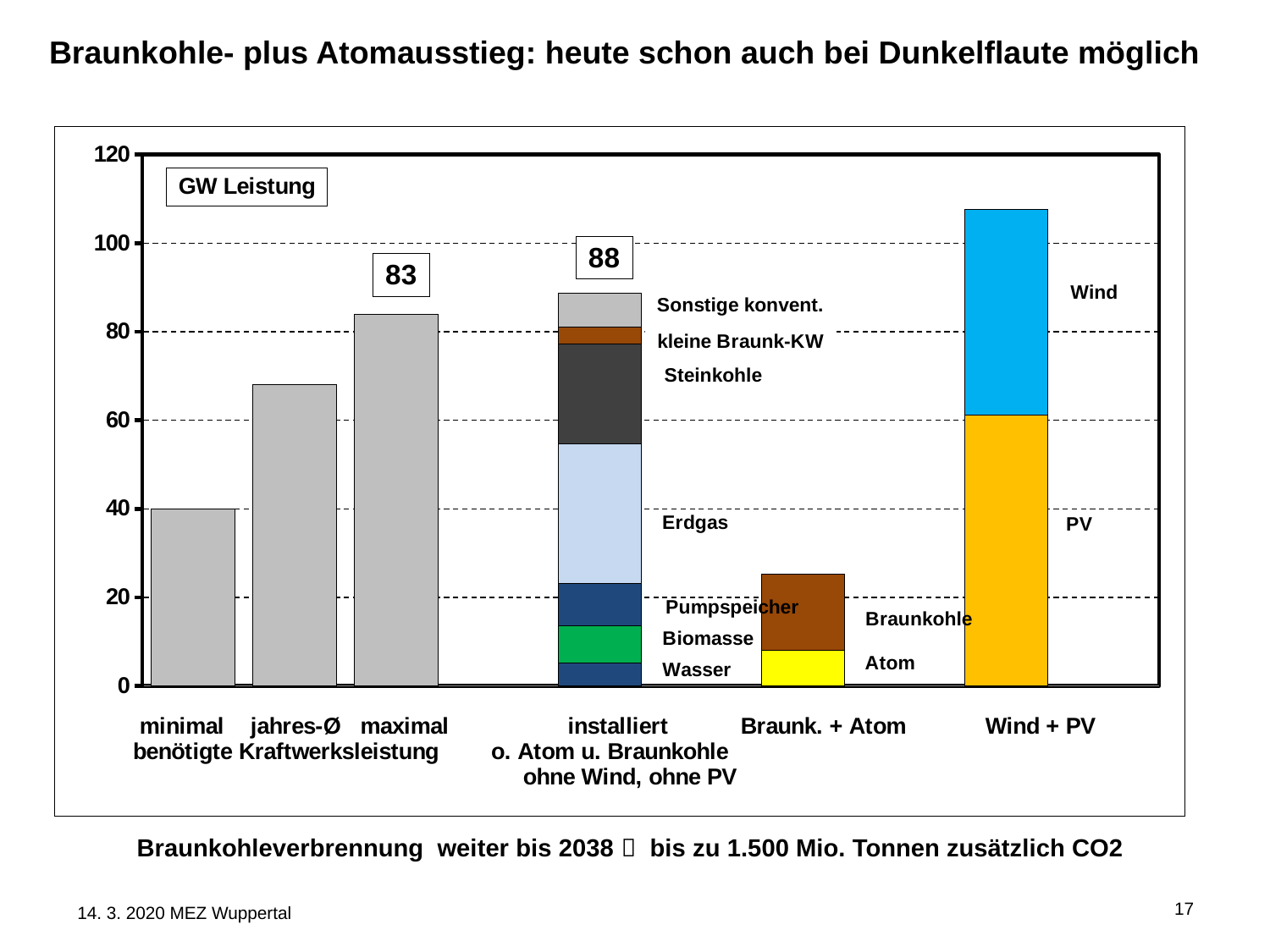
Is the value for 'Braunk. + Atom' greater or less than 40? less Which bar reaches the highest value in the chart? Wind + PV What kind of chart is shown on the slide? bar chart Is the value for 'Wind + PV' greater or less than 100? greater What is the value shown for the 'maximal' bar? 83 What is the value shown for the 'installiert' stacked bar? 88 What is the difference between the 'installiert' bar (88) and the 'maximal' bar (83)? 5 Which bar has the lowest total value in the chart? Braunk. + Atom What unit label is shown in the box at the top left of the chart? GW Leistung Is the value for 'jahres-Ø' greater or less than 60? greater Which is larger, the 'installiert' bar or the 'maximal' bar? installiert